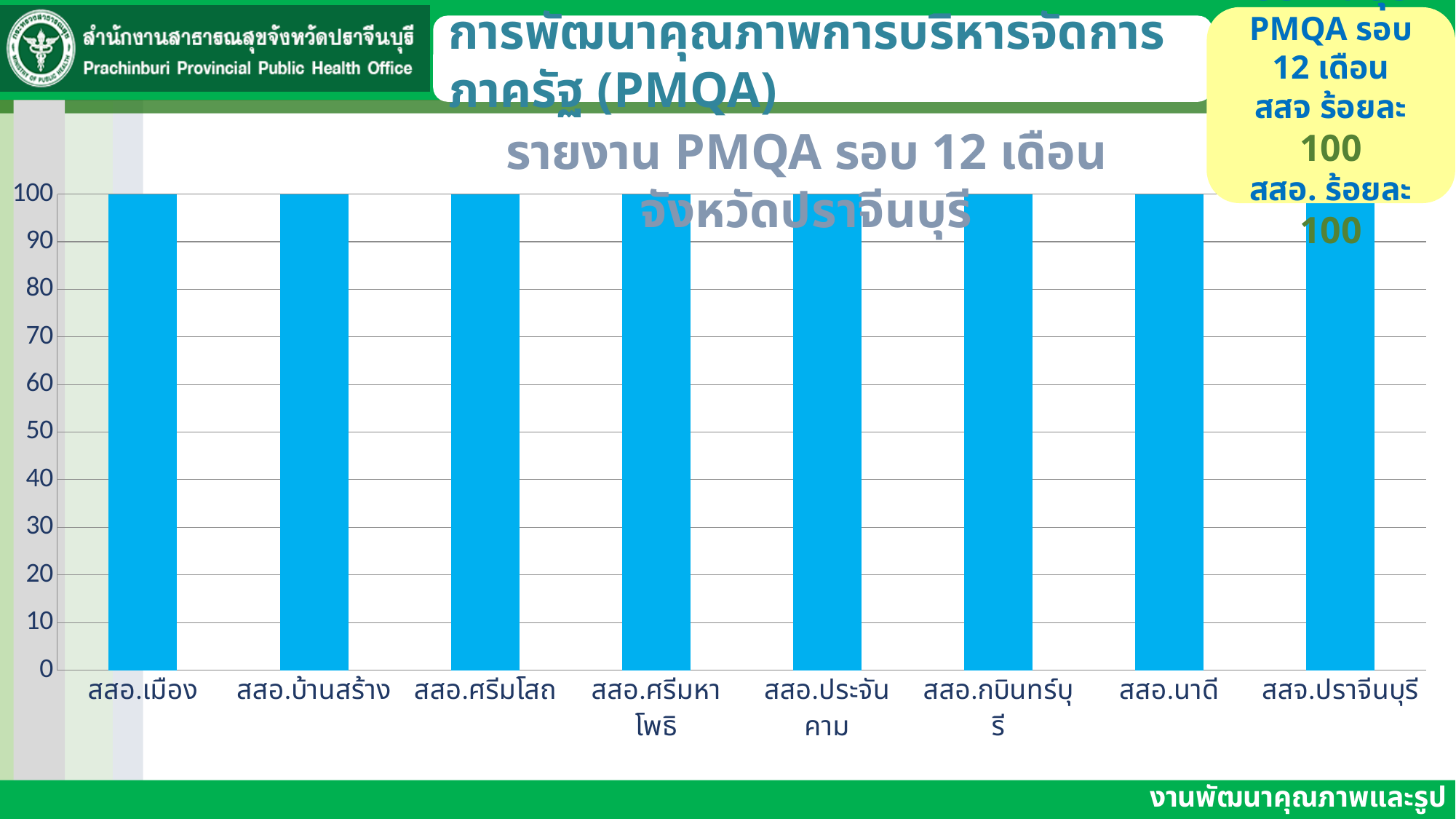
Is the value for สสอ.บ้านสร้าง greater or less than 50? greater What colour are the bars in the chart? blue What is the value for สสอ.กบินทร์บุรี? 100 What is the value for สสจ.ปราจีนบุรี? 100 What is the difference between the values for สสอ.ศรีมโสถ and สสอ.ศรีมหาโพธิ? 0 What is the value for สสอ.นาดี? 100 Do the values rise, fall, or stay the same across the categories from left to right? stay the same What is the title of the chart? รายงาน PMQA รอบ 12 เดือน จังหวัดปราจีนบุรี What kind of chart is shown on the slide? bar chart How many categories are shown on the x axis of the chart? 8 What is the value for สสอ.เมือง? 100 Is the value for สสอ.ประจันคาม greater or less than 90? greater